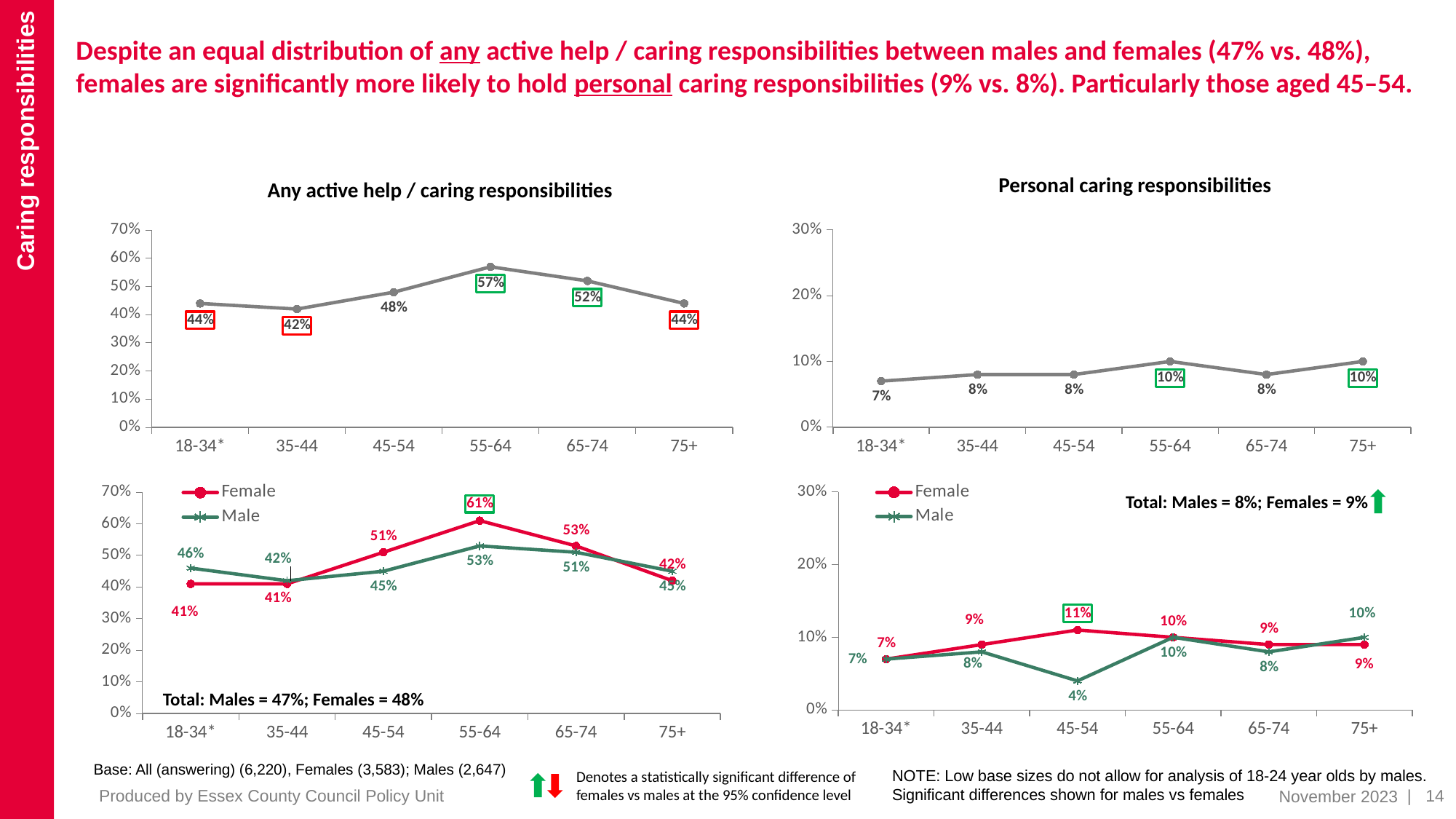
In the top-right chart titled 'Personal caring responsibilities', how many age groups are plotted on the x axis? 6 In the top-left chart titled 'Any active help / caring responsibilities', what is the value for the 55-64 age group? 57% In the bottom-left chart (any active help by gender), what is the Female value for the 55-64 age group? 61% In the top-right chart titled 'Personal caring responsibilities', what is the value for the 18-34* age group? 7% In the top-left chart titled 'Any active help / caring responsibilities', what is the difference between the 55-64 and 75+ values? 13% In the bottom-left chart (any active help by gender), which is larger for the 18-34* age group, the Female or the Male value? Male What type of chart is the top-right chart titled 'Personal caring responsibilities'? Line chart In the top-left chart titled 'Any active help / caring responsibilities', which age group has the lowest value? 35-44 In the bottom-right chart (personal caring by gender), what is the Male value for the 45-54 age group? 4% In the bottom-right chart (personal caring by gender), which age group has the highest Female value? 45-54 In the bottom-left chart (any active help by gender), what is the difference between the Female and Male values for the 55-64 age group? 8% In the bottom-left chart (any active help by gender), how many series does the legend list? 2